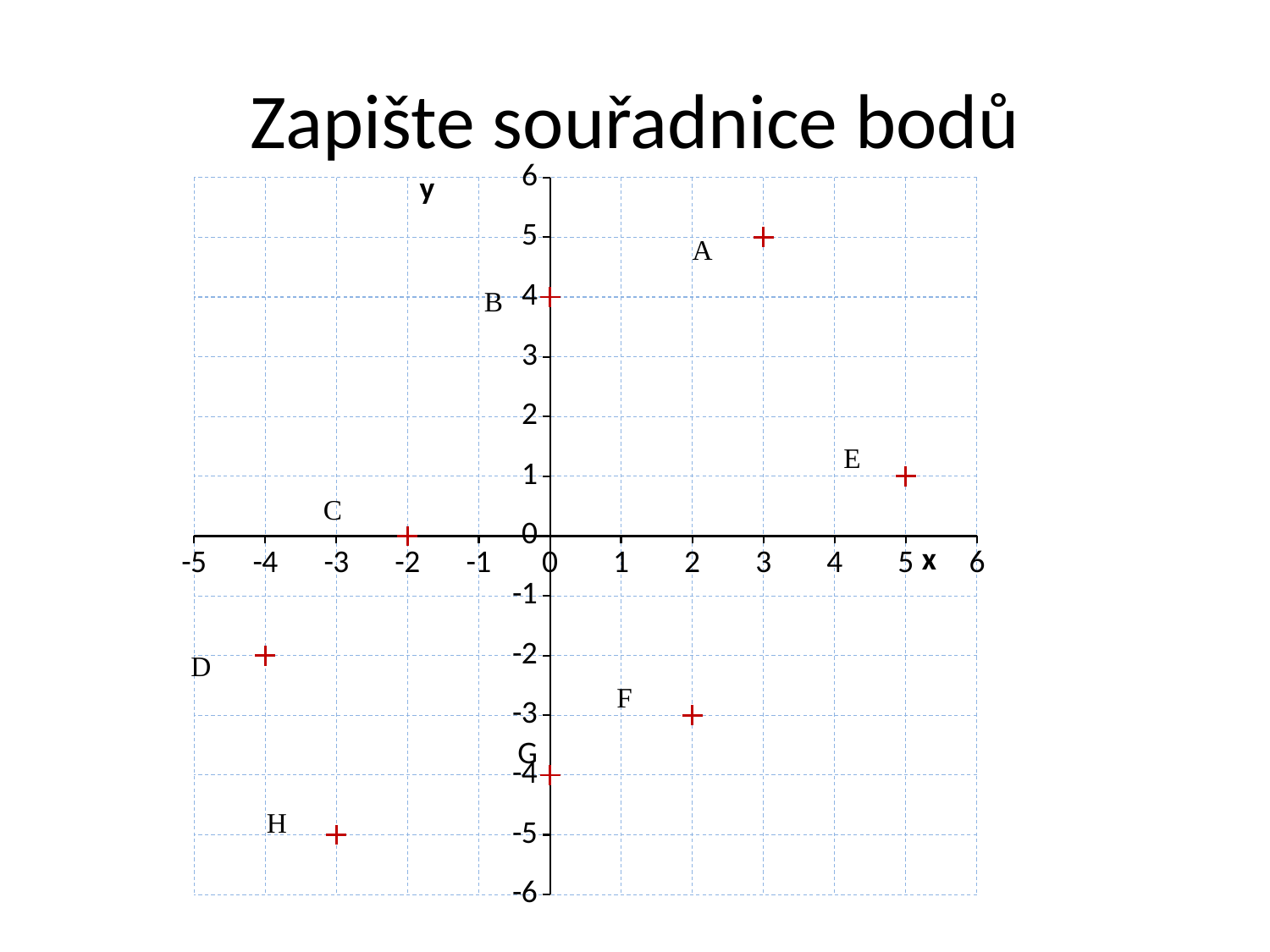
What are the coordinates of point A? (3, 5) What is the x-coordinate of point E? 5 Which point has the lowest y-coordinate? H What is the y-coordinate of point B? 4 Which point has the highest y-coordinate? A Which point has a larger x-coordinate, A or E? E What are the coordinates of point H? (-3, -5) What kind of chart is shown on the slide? scatter chart How many labelled points are plotted on the chart? 8 What are the coordinates of point D? (-4, -2) What is the difference between the y-coordinates of points A and F? 8 Which point has the smallest x-coordinate? D